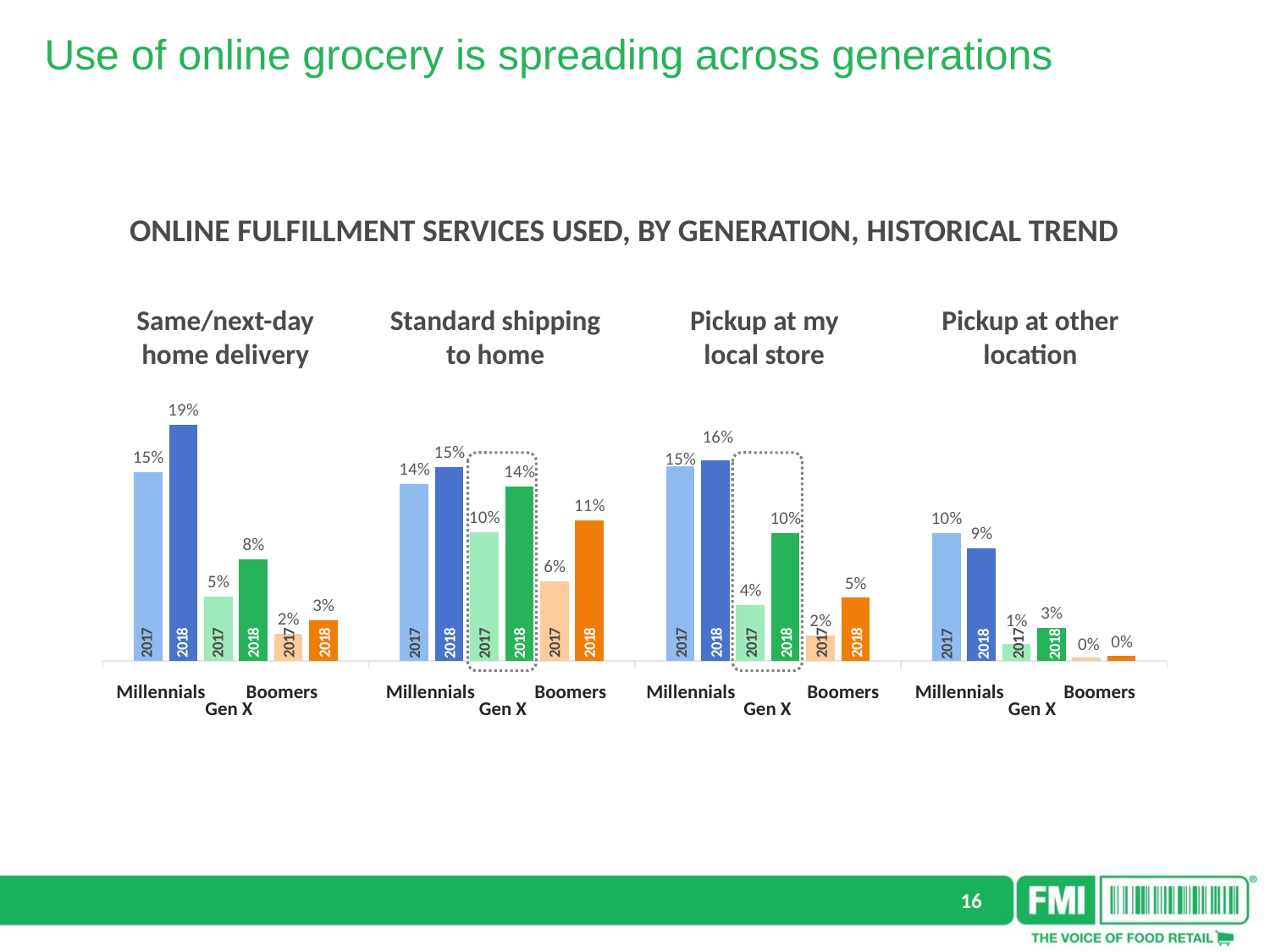
In the 'Pickup at other location' chart, what is the value for Gen X in 2018? 3% In the 'Same/next-day home delivery' chart, what is the value for Millennials in 2018? 19% In the 'Standard shipping to home' chart, which is larger: Gen X in 2018 or Boomers in 2018? Gen X in 2018 In the 'Pickup at my local store' chart, what is the difference between the Gen X values for 2018 and 2017? 6% In the 'Pickup at other location' chart, which is larger for Millennials: the 2017 value or the 2018 value? 2017 In the 'Standard shipping to home' chart, what is the difference between the Boomers values for 2018 and 2017? 5% In the 'Standard shipping to home' chart, what is the value for Gen X in 2017? 10% How many generation categories are shown in each chart? 3 What type of chart is used for 'Pickup at my local store'? Bar chart In the 'Same/next-day home delivery' chart, which generation has the highest value in 2018? Millennials In the 'Pickup at other location' chart, which generation has the lowest value in 2017? Boomers In the 'Pickup at my local store' chart, what is the value for Boomers in 2018? 5%